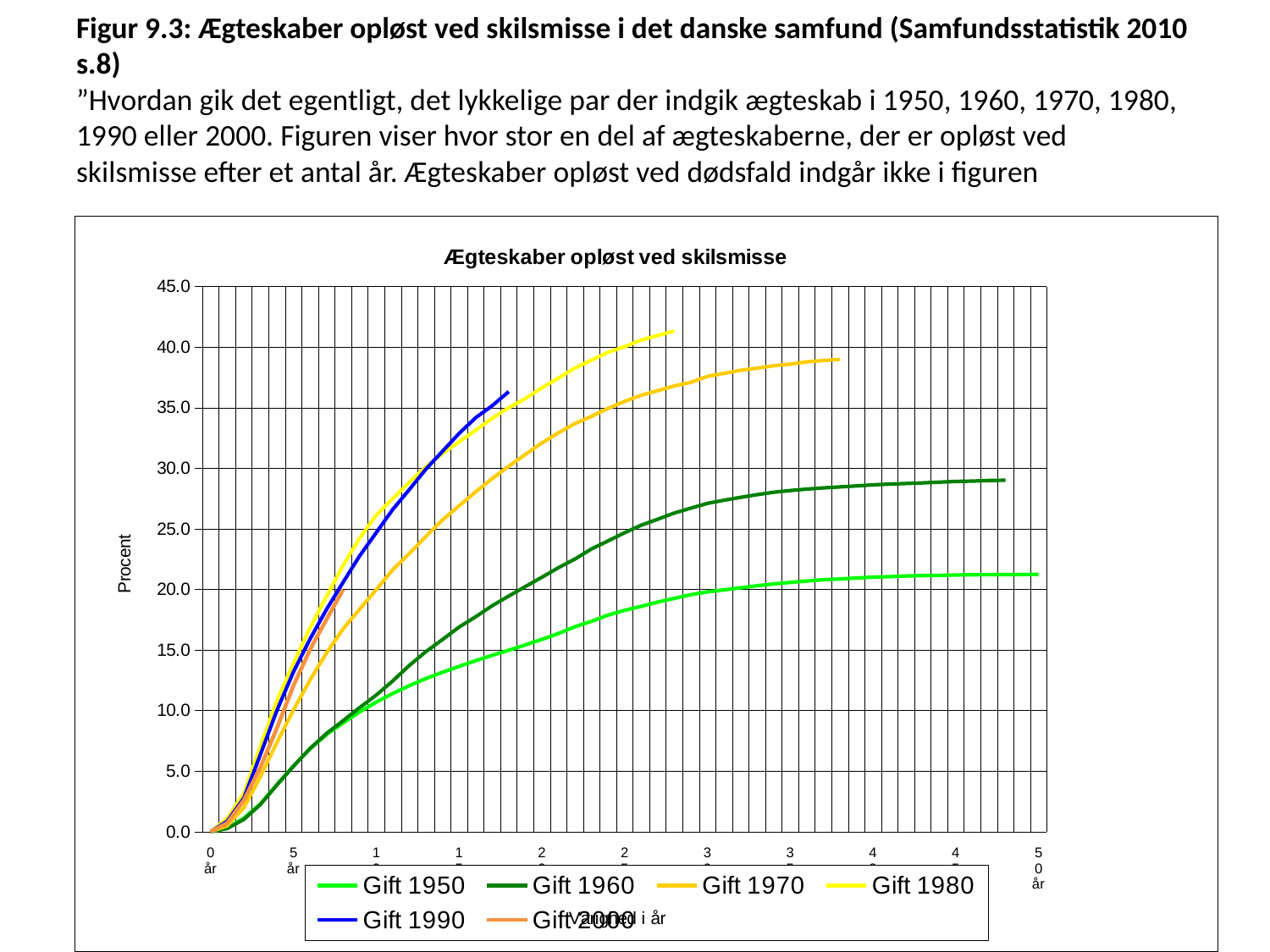
What is the title of the chart? Ægteskaber opløst ved skilsmisse How many series does the legend list? 6 Is the final value for Gift 1950 greater or less than 25.0? less At 25 years, which is higher: Gift 1970 or Gift 1980? Gift 1980 Which series reaches the highest value on the chart? Gift 1980 Do the values for Gift 1960 rise or fall as the number of years increases? rise At 20 years, which is higher: Gift 1950 or Gift 1960? Gift 1960 Is the final value for Gift 1970 greater or less than 35.0? greater What is the label on the vertical axis of the chart? Procent What kind of chart is shown on the slide? line chart Is the final value for Gift 1960 greater or less than 25.0? greater